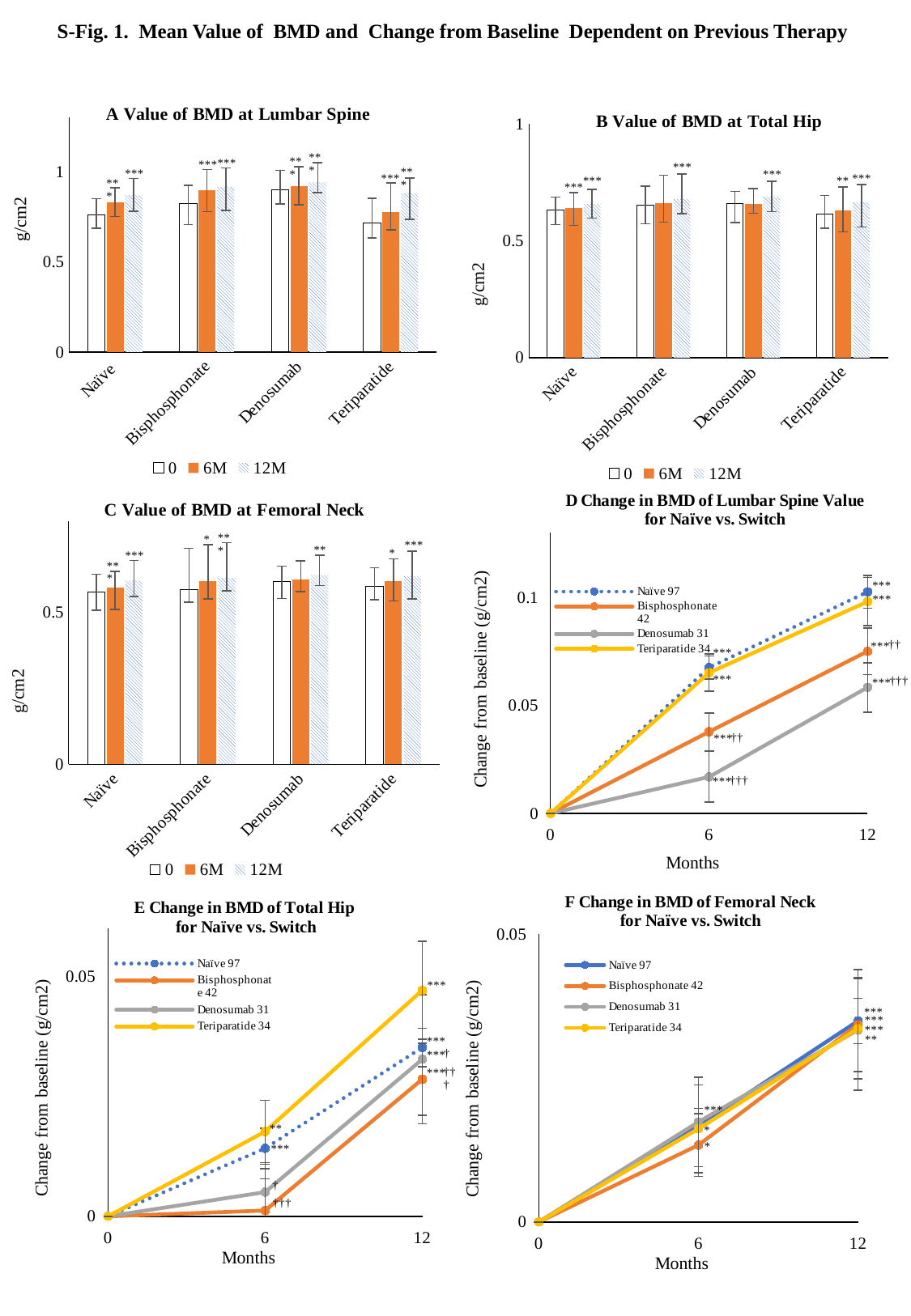
In chart D, "Change in BMD of Lumbar Spine Value for Naïve vs. Switch", which is larger at 12 months: Naïve 97 or Denosumab 31? Naïve 97 How many series does the legend of chart C, "Value of BMD at Femoral Neck", list? 3 What kind of chart is chart D, "Change in BMD of Lumbar Spine Value for Naïve vs. Switch"? line chart In chart E, "Change in BMD of Total Hip for Naïve vs. Switch", which series has the highest value at 12 months? Teriparatide 34 In chart F, "Change in BMD of Femoral Neck for Naïve vs. Switch", do the values rise or fall from 0 to 12 months? rise What kind of chart is chart A, "Value of BMD at Lumbar Spine"? bar chart In chart C, "Value of BMD at Femoral Neck", is the value for Teriparatide at 6M greater or less than 0.5? greater In chart D, "Change in BMD of Lumbar Spine Value for Naïve vs. Switch", is the value for Bisphosphonate 42 at 6 months greater or less than 0.05? less In chart B, "Value of BMD at Total Hip", is the value for Denosumab at 12M greater or less than 0.5? greater How many series does the legend of chart D, "Change in BMD of Lumbar Spine Value for Naïve vs. Switch", list? 4 How many categories are shown on the x axis of chart B, "Value of BMD at Total Hip"? 4